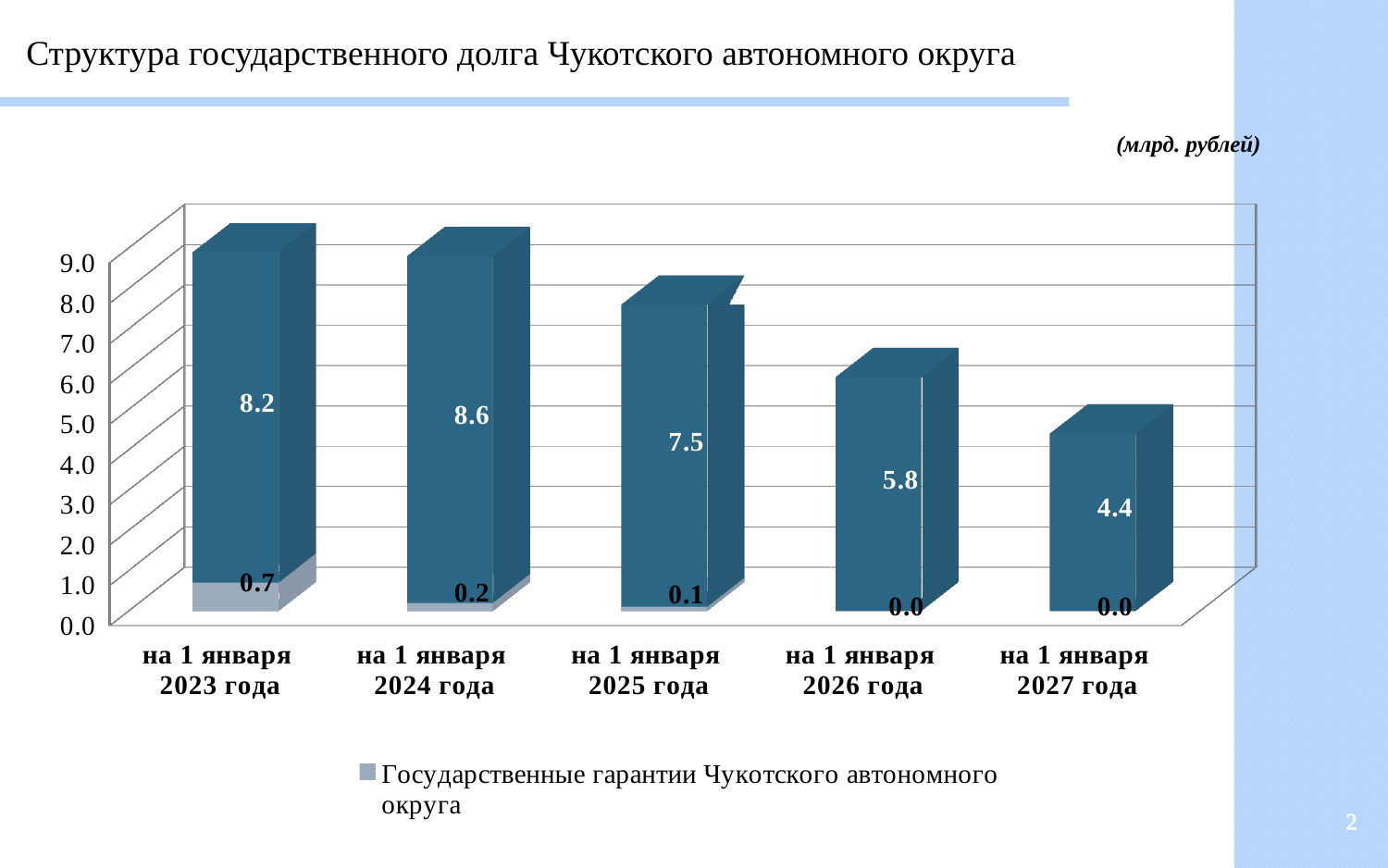
How many dates (categories) are shown on the x axis? 5 Which is larger: the dark blue segment for на 1 января 2023 года or for на 1 января 2025 года? на 1 января 2023 года In which year is the dark blue segment the smallest? на 1 января 2027 года What is the value of Государственные гарантии Чукотского автономного округа on 1 January 2025 (на 1 января 2025 года)? 0.1 What is the difference between the dark blue segment values for на 1 января 2024 года and на 1 января 2026 года? 2.8 What is the value labelled on the dark blue segment of the bar for на 1 января 2024 года? 8.6 What kind of chart is shown on the slide? Bar chart Do the values of Государственные гарантии Чукотского автономного округа rise or fall from 2023 to 2027? Fall What is the value of Государственные гарантии Чукотского автономного округа on 1 January 2023 (на 1 января 2023 года)? 0.7 What is the value labelled on the dark blue segment of the bar for на 1 января 2027 года? 4.4 In which year is the value of Государственные гарантии Чукотского автономного округа the highest? на 1 января 2023 года What is the total of the stacked bar for на 1 января 2023 года? 8.9